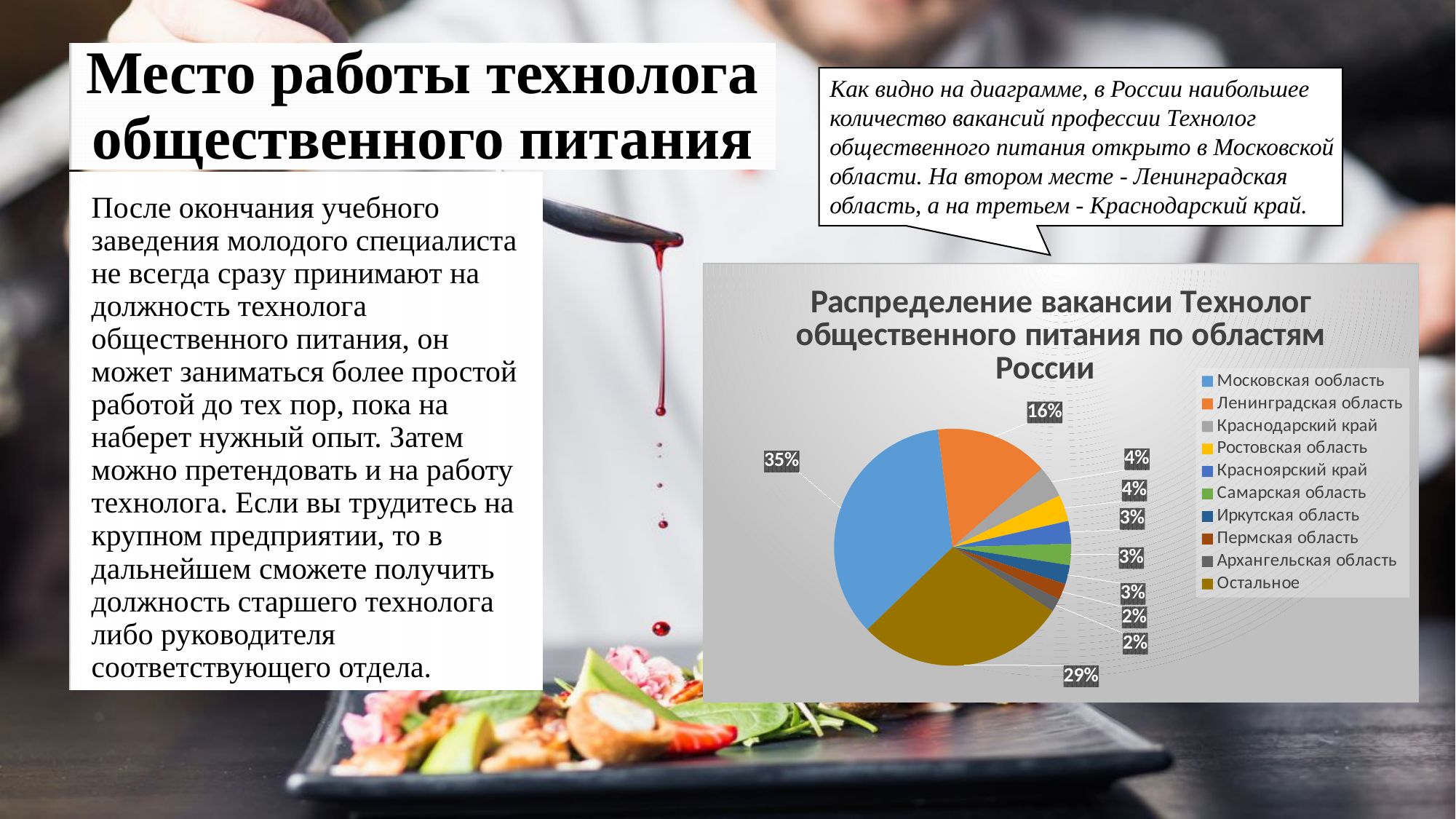
What share of the pie does Остальное have? 29% How many categories does the legend list? 10 Which is larger, the share of Ленинградская область or the share of Остальное? Остальное What is the value for Пермская область? 2% What share of the pie does Ленинградская область have? 16% Which category has the largest slice of the pie? Московская ообласть What share of the pie does Московская ообласть have? 35% What is the value for Краснодарский край? 4% What is the difference between the shares of Московская ообласть and Ленинградская область? 19% What kind of chart is shown on the slide? pie chart What colour is the slice for Остальное? gold (dark yellow) What is the title of the chart? Распределение вакансии Технолог общественного питания по областям России